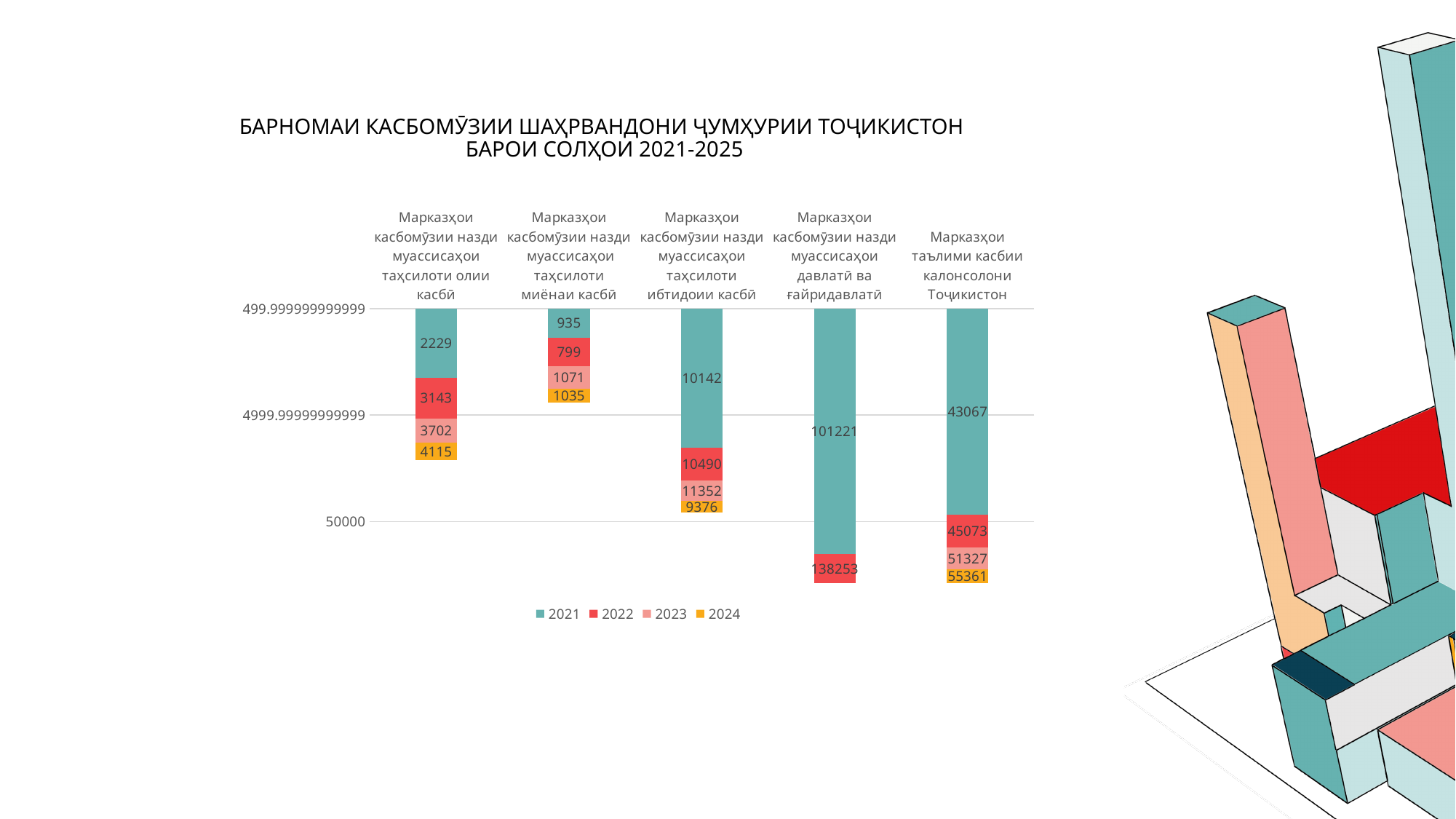
What is the 2021 value for Марказҳои касбомӯзии назди муассисаҳои давлатӣ ва ғайридавлатӣ? 101221 What type of chart is shown on the slide? stacked bar chart Do the values for Марказҳои касбомӯзии назди муассисаҳои таҳсилоти олии касбӣ rise or fall from 2021 to 2024? rise How many categories are plotted on the x axis? 5 How many series does the legend list? 4 What is the 2024 value for Марказҳои таълими касбии калонсолони Тоҷикистон? 55361 Which category has the lowest 2022 value? Марказҳои касбомӯзии назди муассисаҳои таҳсилоти миёнаи касбӣ What is the 2023 value for Марказҳои касбомӯзии назди муассисаҳои таҳсилоти ибтидоии касбӣ? 11352 Which is larger for Марказҳои касбомӯзии назди муассисаҳои таҳсилоти ибтидоии касбӣ: the 2023 value or the 2024 value? 2023 What is the difference between the 2022 and 2021 values for Марказҳои касбомӯзии назди муассисаҳои давлатӣ ва ғайридавлатӣ? 37032 What is the total of the stacked bar for Марказҳои касбомӯзии назди муассисаҳои таҳсилоти олии касбӣ? 13189